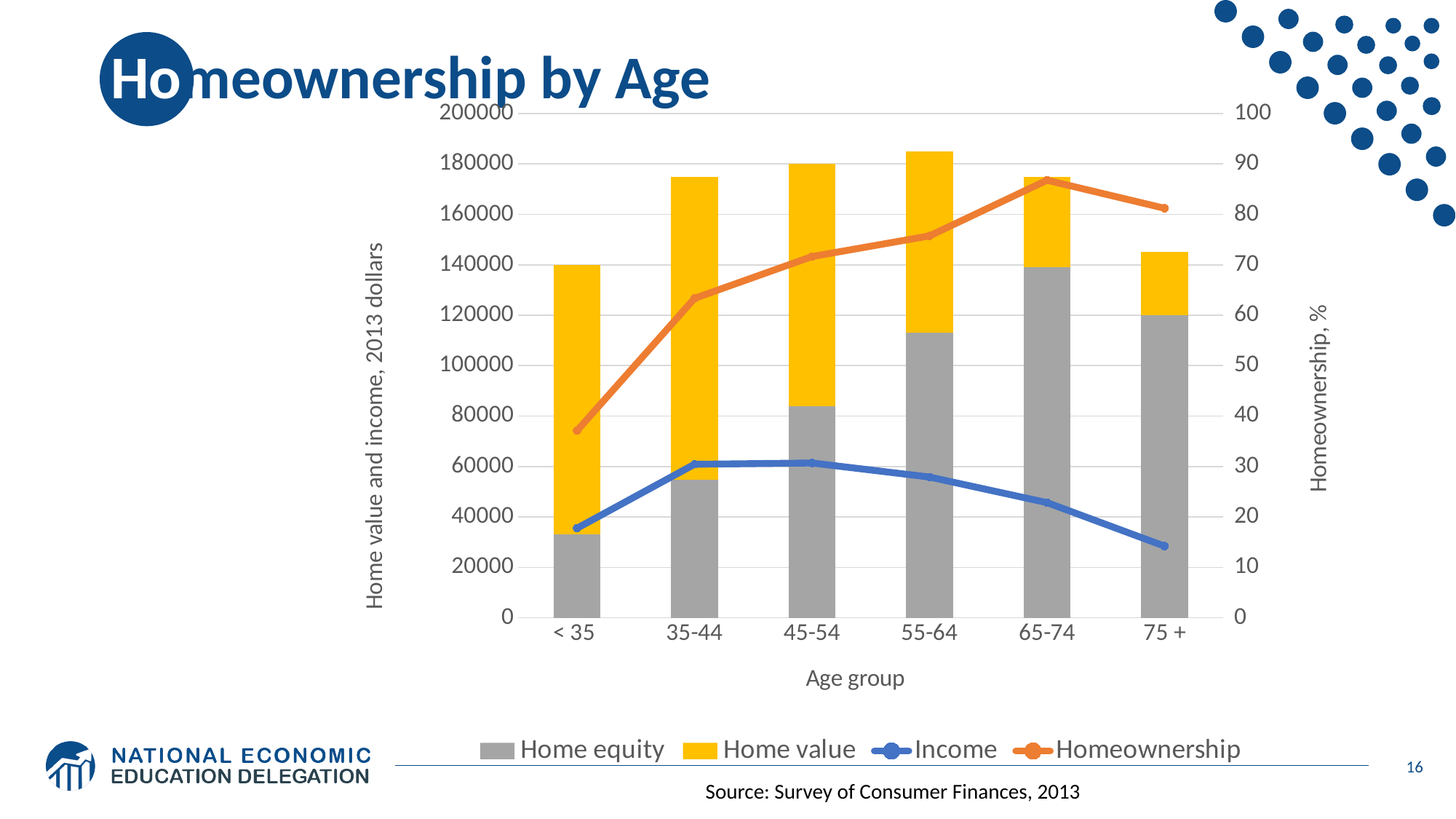
Which age group has the higher income, 35-44 or 75 +? 35-44 Which age group has the highest homeownership rate? 65-74 How many age groups are shown on the x axis? 6 Is the home equity for the 55-64 age group greater or less than 100000? greater What is the label of the right-hand vertical axis? Homeownership, % What kind of chart is shown on the slide? A combination chart with stacked bars and lines How many series does the legend list? 4 Which age group has the largest home equity? 65-74 Which age group has the smallest home equity? < 35 Does the homeownership rate rise or fall from the < 35 group to the 65-74 group? rise Is the homeownership rate for the < 35 age group greater or less than 50? less Which age group has the lowest homeownership rate? < 35